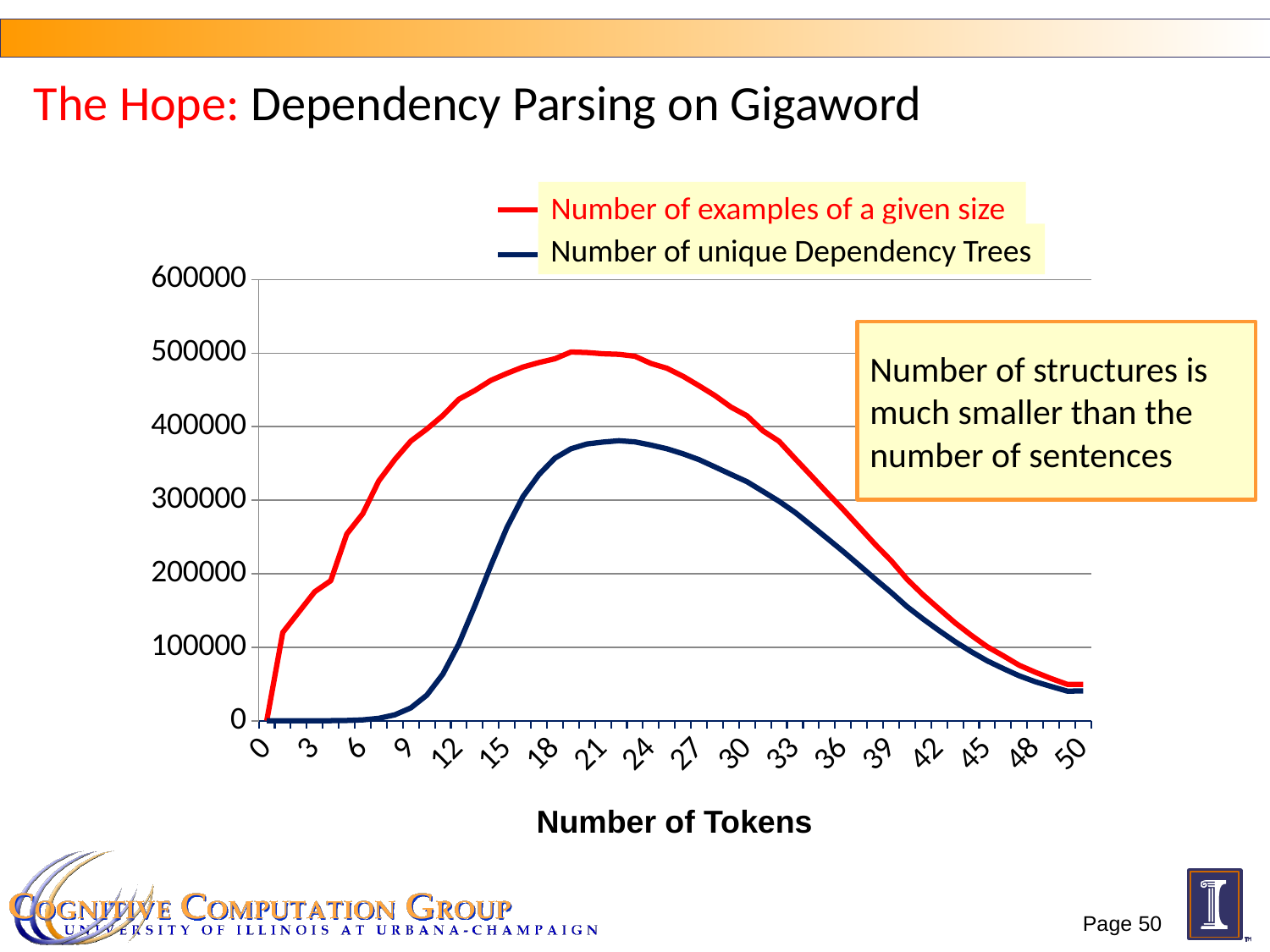
Is the value of Number of examples of a given size at 50 tokens greater or less than 100000? less How many series does the legend list? 2 Does the Number of unique Dependency Trees rise or fall between 12 and 18 tokens? rise What is the title of the x axis? Number of Tokens Which series is drawn in red? Number of examples of a given size Is the value of Number of examples of a given size at 12 tokens greater or less than 400000? greater At 21 tokens, which series has the larger value: Number of examples of a given size or Number of unique Dependency Trees? Number of examples of a given size Is the value of Number of unique Dependency Trees at 21 tokens greater or less than 400000? less What kind of chart is shown on the slide? line chart Does the Number of examples of a given size rise or fall between 24 and 48 tokens? fall